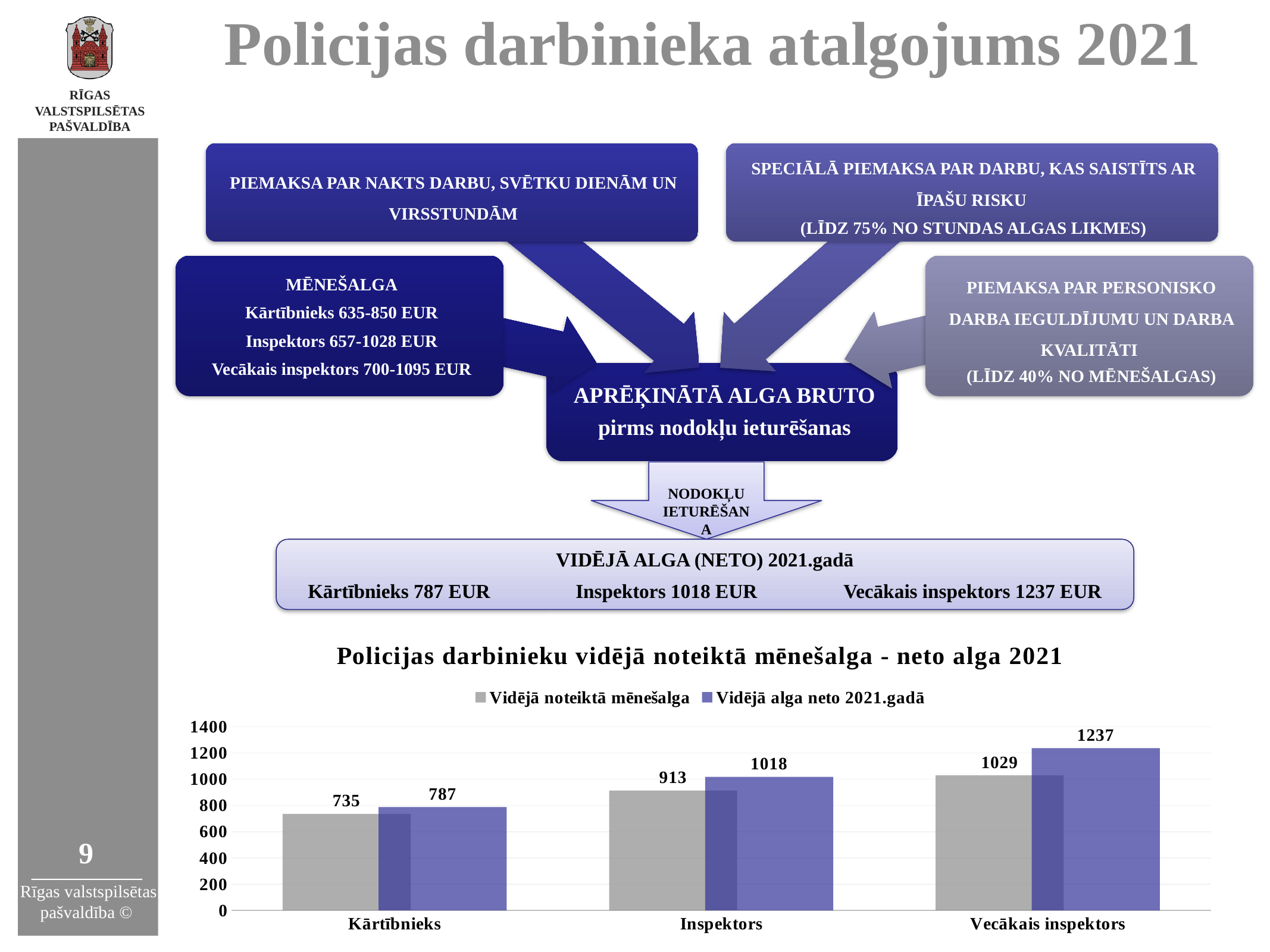
How many series does the chart legend list? 2 Which category has the highest Vidējā alga neto 2021.gadā? Vecākais inspektors How many categories are shown on the x axis of the chart? 3 What is the value of Vidējā noteiktā mēnešalga for Vecākais inspektors? 1029 What type of chart is shown on the slide? bar chart What is the difference between Vidējā alga neto 2021.gadā for Inspektors and for Kārtībnieks? 231 Which category has the lowest Vidējā noteiktā mēnešalga? Kārtībnieks What is the value of Vidējā noteiktā mēnešalga for Kārtībnieks? 735 Which is larger for Inspektors: Vidējā noteiktā mēnešalga or Vidējā alga neto 2021.gadā? Vidējā alga neto 2021.gadā What is the value of Vidējā alga neto 2021.gadā for Inspektors? 1018 What is the difference between Vidējā alga neto 2021.gadā and Vidējā noteiktā mēnešalga for Vecākais inspektors? 208 Is the value of Vidējā alga neto 2021.gadā for Kārtībnieks greater or less than 800? less